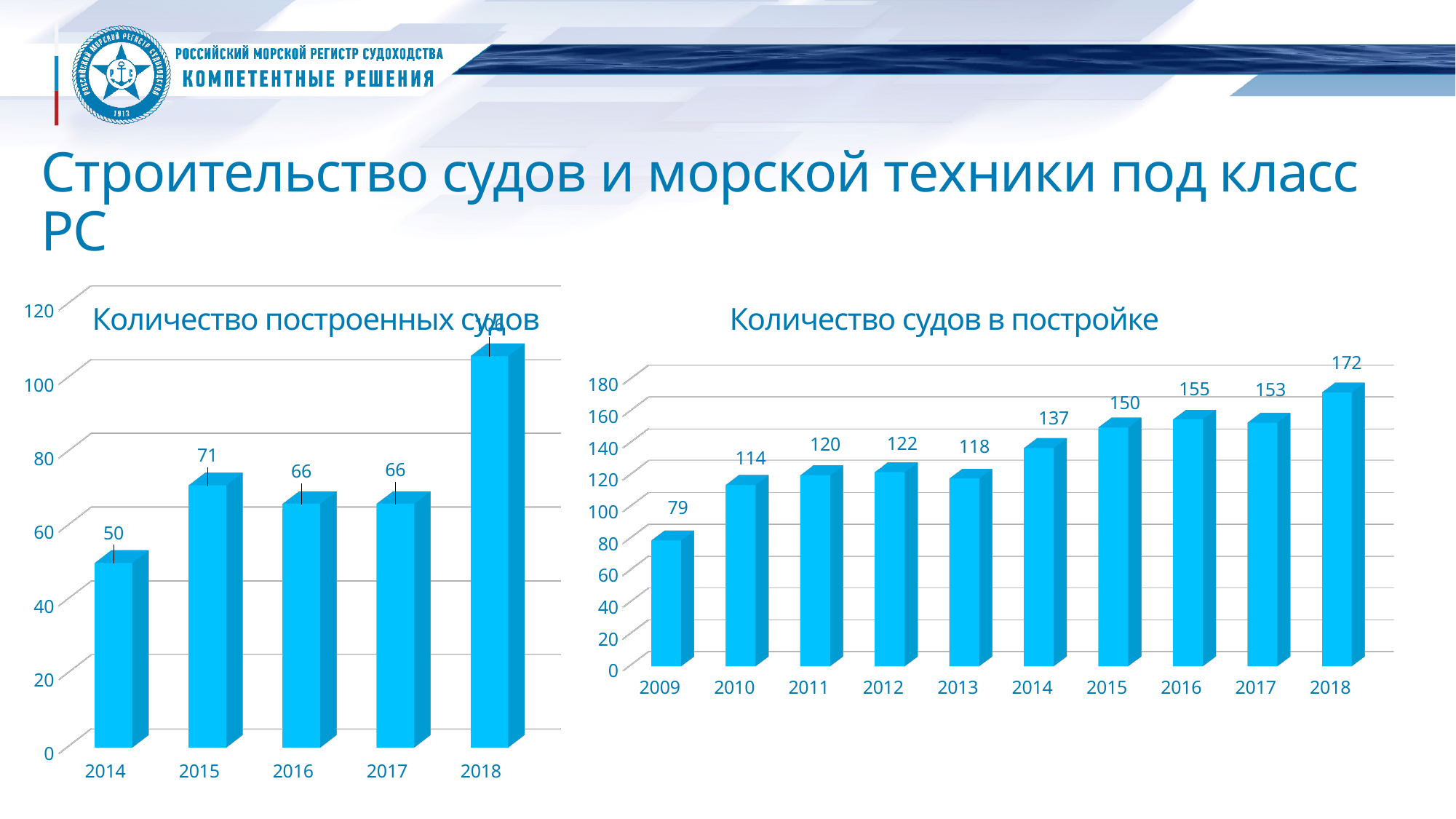
In the chart 'Количество построенных судов', which year has the highest value? 2018 In the chart 'Количество построенных судов', what is the value for 2015? 71 In the chart 'Количество судов в постройке', which year has the lowest value? 2009 In the chart 'Количество судов в постройке', how many years are shown on the x axis? 10 In the chart 'Количество построенных судов', what is the value for 2014? 50 What kind of chart is 'Количество судов в постройке'? bar chart In the chart 'Количество судов в постройке', what is the value for 2018? 172 In the chart 'Количество судов в постройке', what is the value for 2013? 118 In the chart 'Количество судов в постройке', which is larger, the value for 2016 or the value for 2017? 2016 In the chart 'Количество построенных судов', what is the difference between the values for 2015 and 2014? 21 In the chart 'Количество построенных судов', is the value for 2018 greater or less than 100? greater In the chart 'Количество построенных судов', which year has the lowest value? 2014